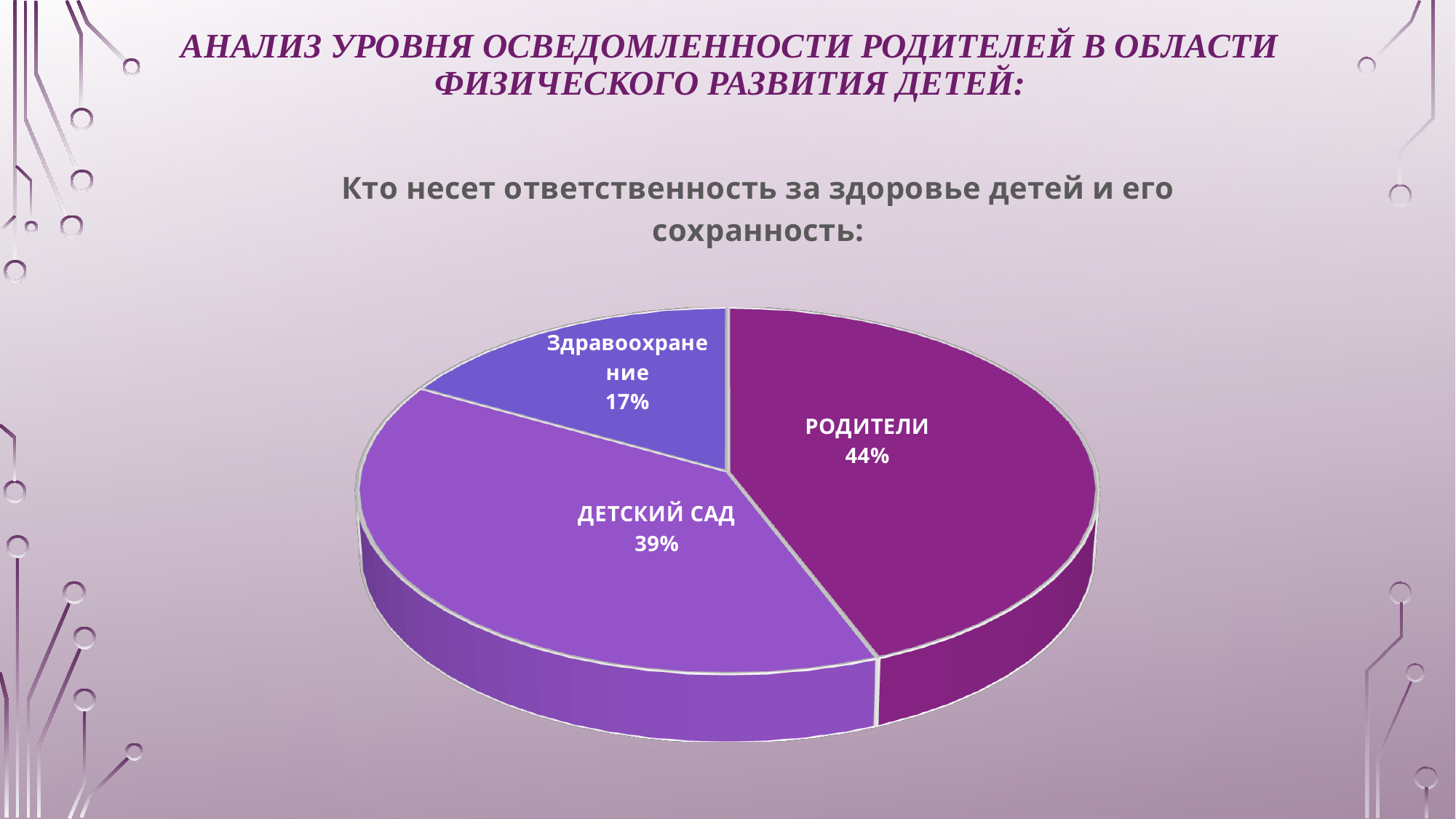
What kind of chart is shown on the slide? pie chart What share of the pie is labelled Здравоохранение? 17% What is the difference in percentage points between the РОДИТЕЛИ slice and the ДЕТСКИЙ САД slice? 5 What share of the pie is labelled ДЕТСКИЙ САД? 39% Which slice of the pie is the smallest? Здравоохранение How many slices does the pie chart have? 3 Which slice of the pie is the largest? РОДИТЕЛИ What is the title of the chart? Кто несет ответственность за здоровье детей и его сохранность: What is the combined share of the РОДИТЕЛИ and ДЕТСКИЙ САД slices? 83% What share of the pie is labelled РОДИТЕЛИ? 44% Which is larger, the share for ДЕТСКИЙ САД or the share for Здравоохранение? ДЕТСКИЙ САД What is the difference in percentage points between the ДЕТСКИЙ САД slice and the Здравоохранение slice? 22